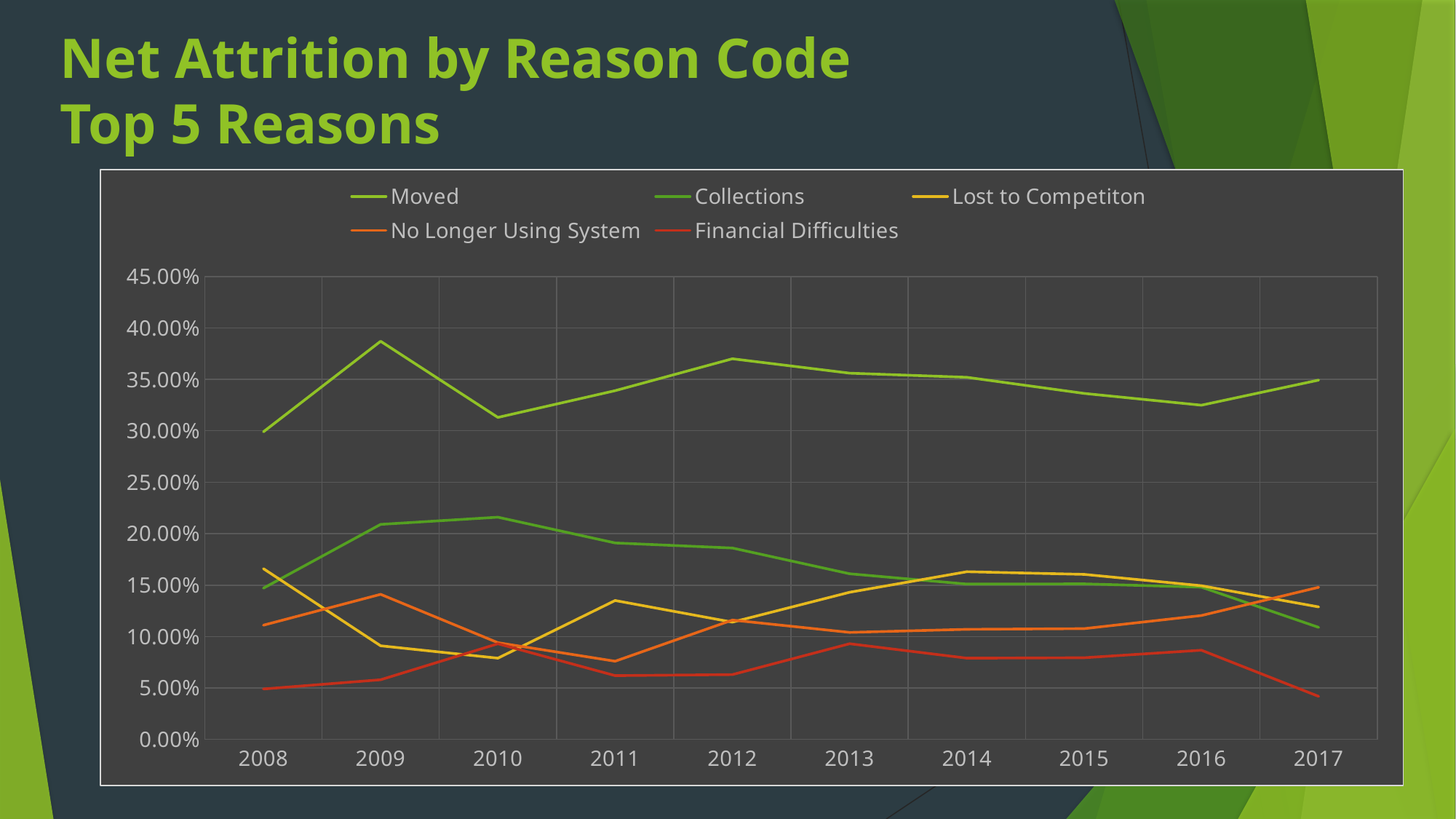
How many series does the legend list? 5 In 2017, which is larger: Collections or No Longer Using System? No Longer Using System Is the value for Financial Difficulties in 2017 greater or less than 5.00%? less What type of chart is shown on the slide? Line chart Which series has the highest values across all years? Moved How many years are plotted along the x axis? 10 Does the Collections series rise or fall from 2010 to 2017? Fall Is the value for Collections in 2010 greater or less than 20.00%? greater What is the title of the slide? Net Attrition by Reason Code Top 5 Reasons Is the value for Moved in 2009 greater or less than 35.00%? greater In which year does the Moved series reach its peak? 2009 Which series has the lowest value in 2008? Financial Difficulties